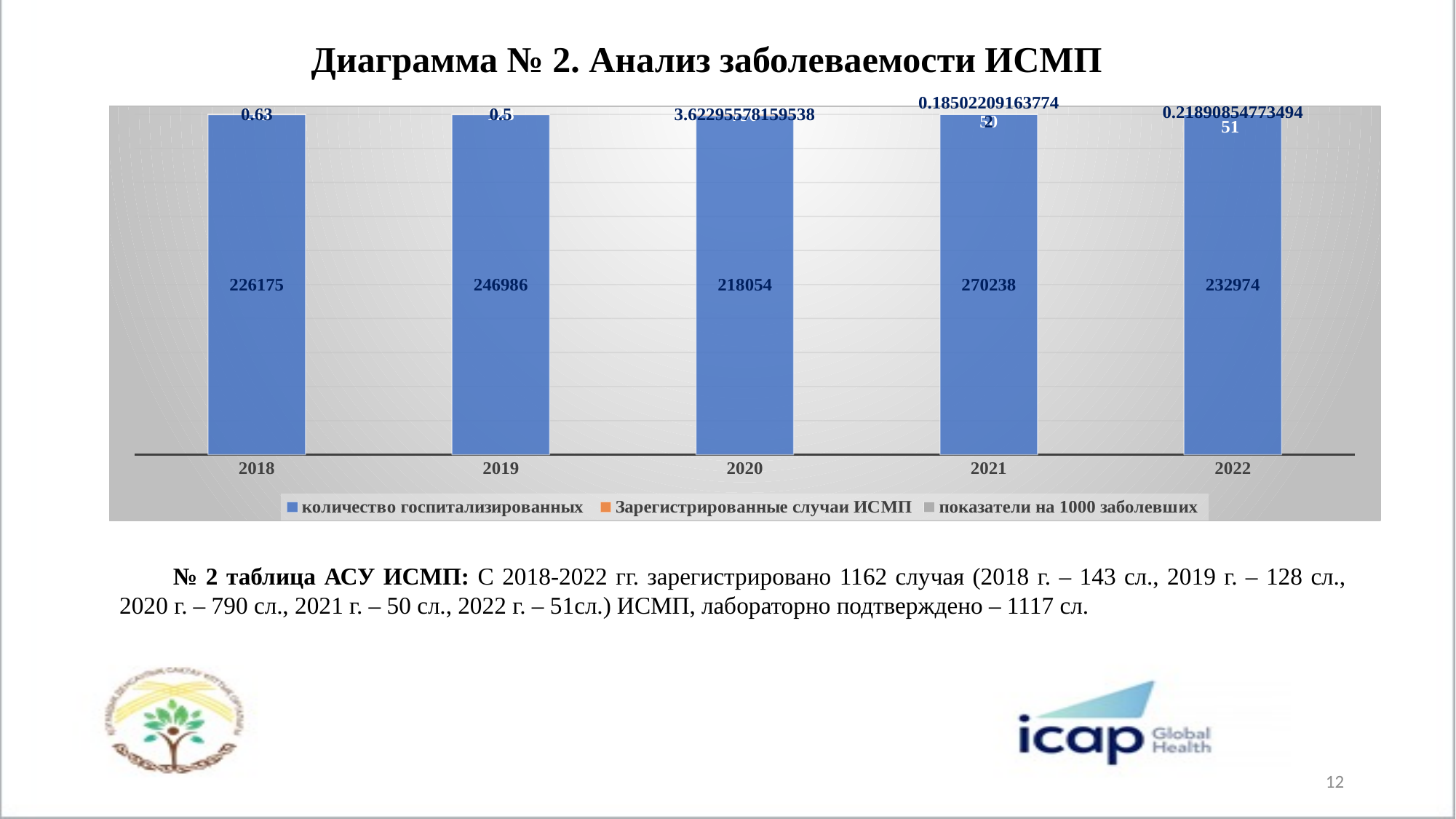
What is the title of the chart? Диаграмма № 2. Анализ заболеваемости ИСМП Which year has the lowest value for 'количество госпитализированных'? 2020 What is the value of 'количество госпитализированных' for 2021? 270238 What is the value of 'количество госпитализированных' for 2022? 232974 What is the 'показатели на 1000 заболевших' value labelled for 2018? 0.63 What is the value of 'количество госпитализированных' for 2018? 226175 Which year has the highest value for 'количество госпитализированных'? 2021 How many years are shown on the x axis of the chart? 5 Which year has the larger 'количество госпитализированных' value, 2019 or 2022? 2019 What is the difference between the 'количество госпитализированных' values for 2021 and 2020? 52184 What type of chart is shown on the slide? bar chart How many series does the chart legend list? 3